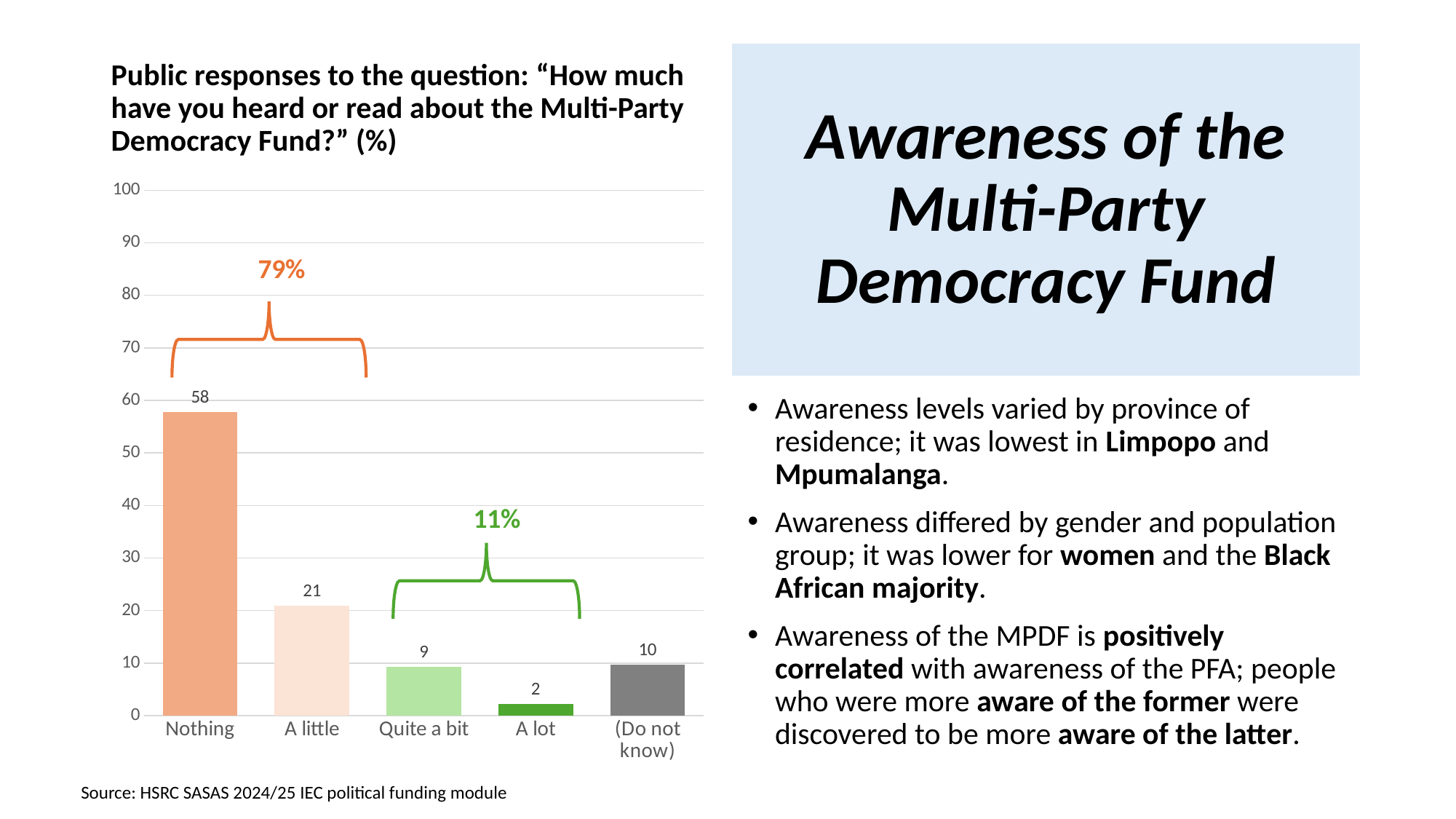
What percentage is shown by the orange bracket above the "Nothing" and "A little" bars? 79% What kind of chart is this? Bar chart How many categories are shown on the x axis? 5 Which is larger, the value for "Quite a bit" or the value for "(Do not know)"? (Do not know) What is the value for "A little"? 21 What is the value for "(Do not know)"? 10 Which category has the highest value? Nothing Which category has the lowest value? A lot What is the value for "A lot"? 2 What is the value for "Nothing"? 58 What is the value for "Quite a bit"? 9 What is the difference between the values for "Nothing" and "A little"? 37